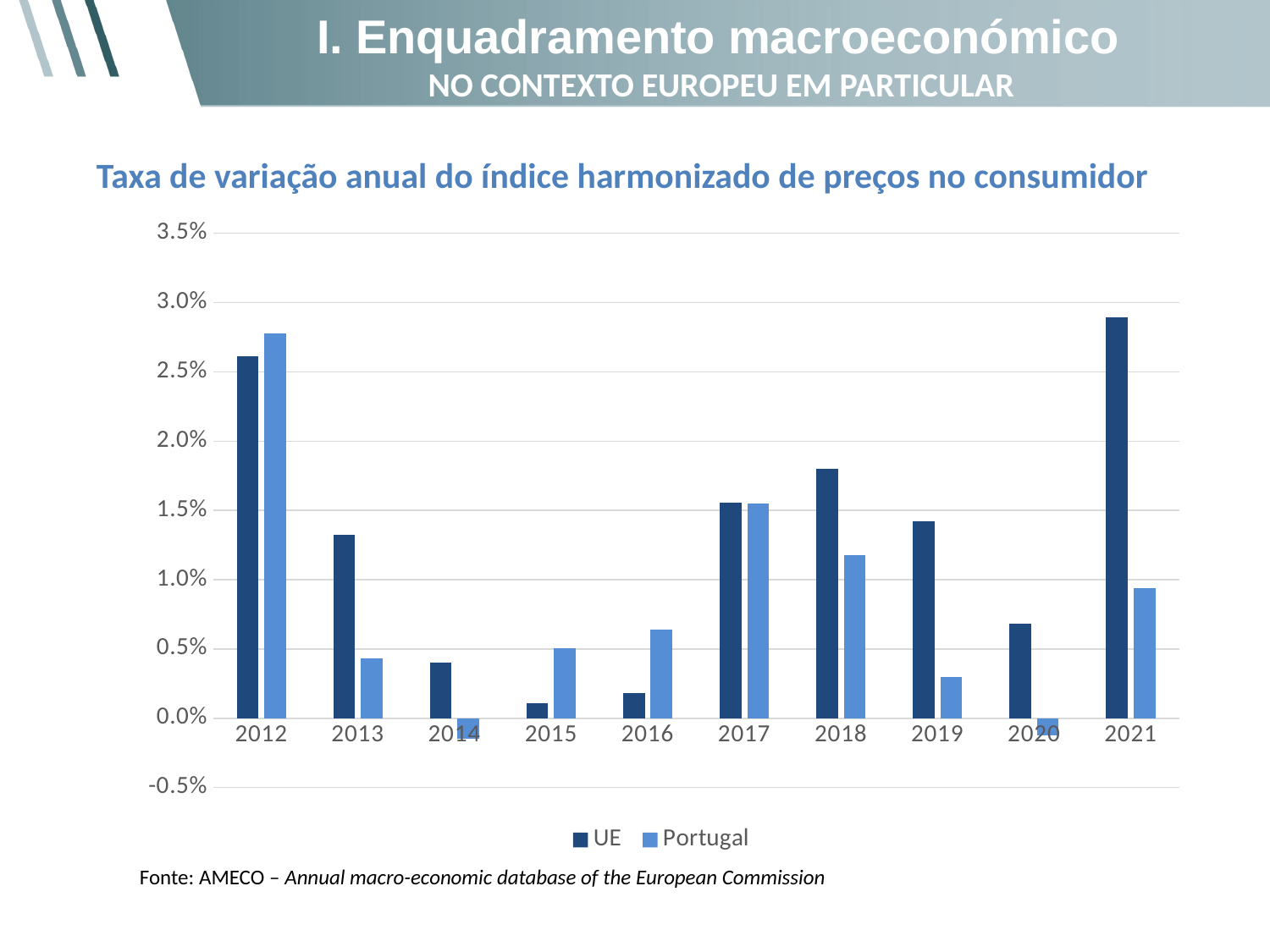
Is the UE value for 2021 greater or less than 2.5%? greater In which year is the UE value highest? 2021 What is the title of the chart? Taxa de variação anual do índice harmonizado de preços no consumidor Is the Portugal value for 2014 greater or less than 0.0%? less In 2021, which is larger, the UE value or the Portugal value? UE In which year is the UE value lowest? 2015 In 2012, which is larger, the UE value or the Portugal value? Portugal In which year is the Portugal value highest? 2012 How many series does the legend list? 2 How many years are shown on the x axis? 10 What type of chart is shown on the slide? bar chart